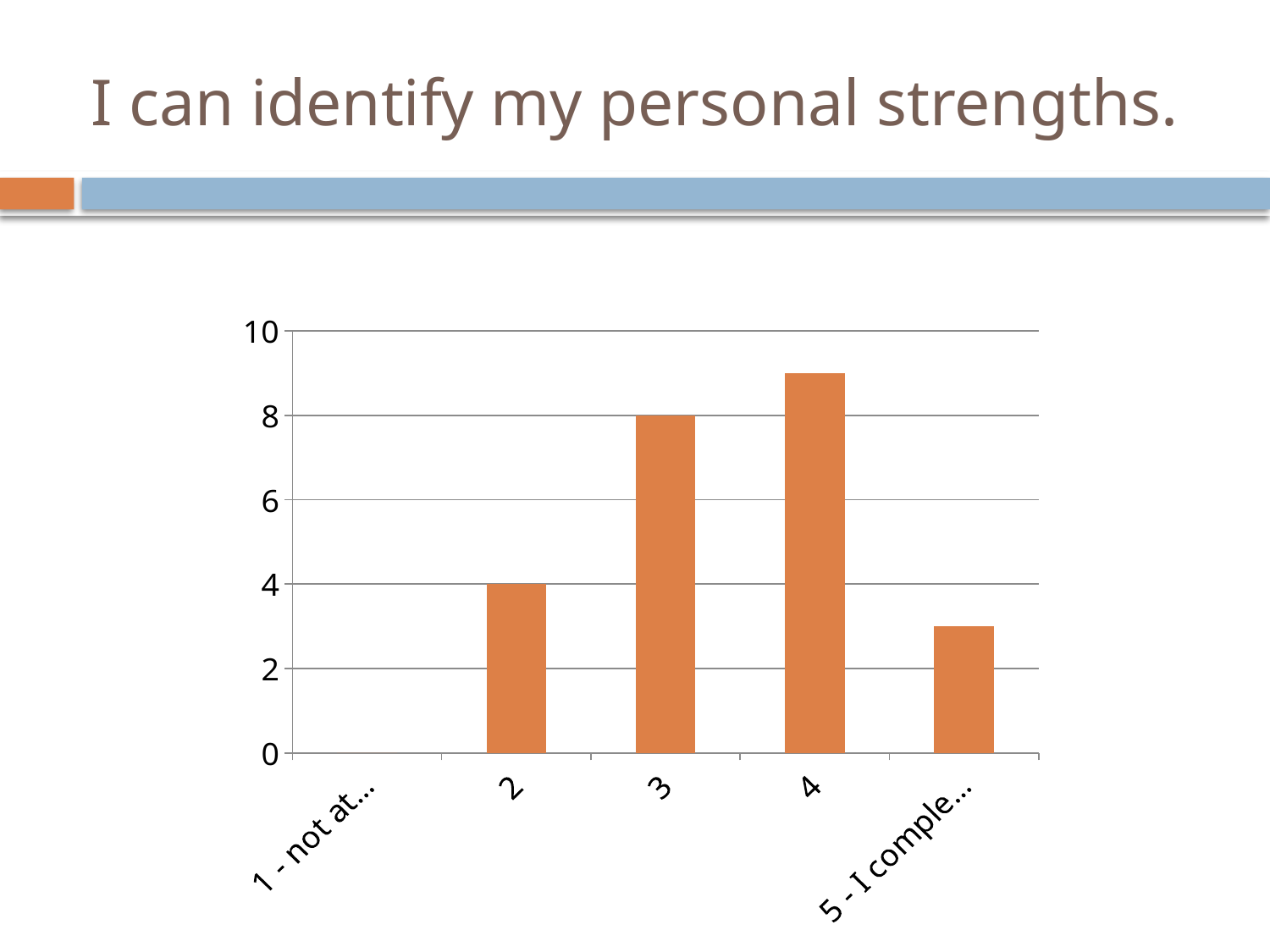
Which category has the lowest value? 1 - not at... Which has the larger value, category 2 or category 3? 3 Is the value for category 4 greater or less than 8? greater What type of chart is shown on the slide? bar chart What is the value for category 2? 4 How many categories are shown on the x axis of the chart? 5 Is the value for category 5 - I comple... greater or less than 4? less What is the difference between the values for category 3 and category 2? 4 What is the value for category 3? 8 What colour are the bars in the chart? orange What is the title of the chart on the slide? I can identify my personal strengths. Which category has the highest value? 4